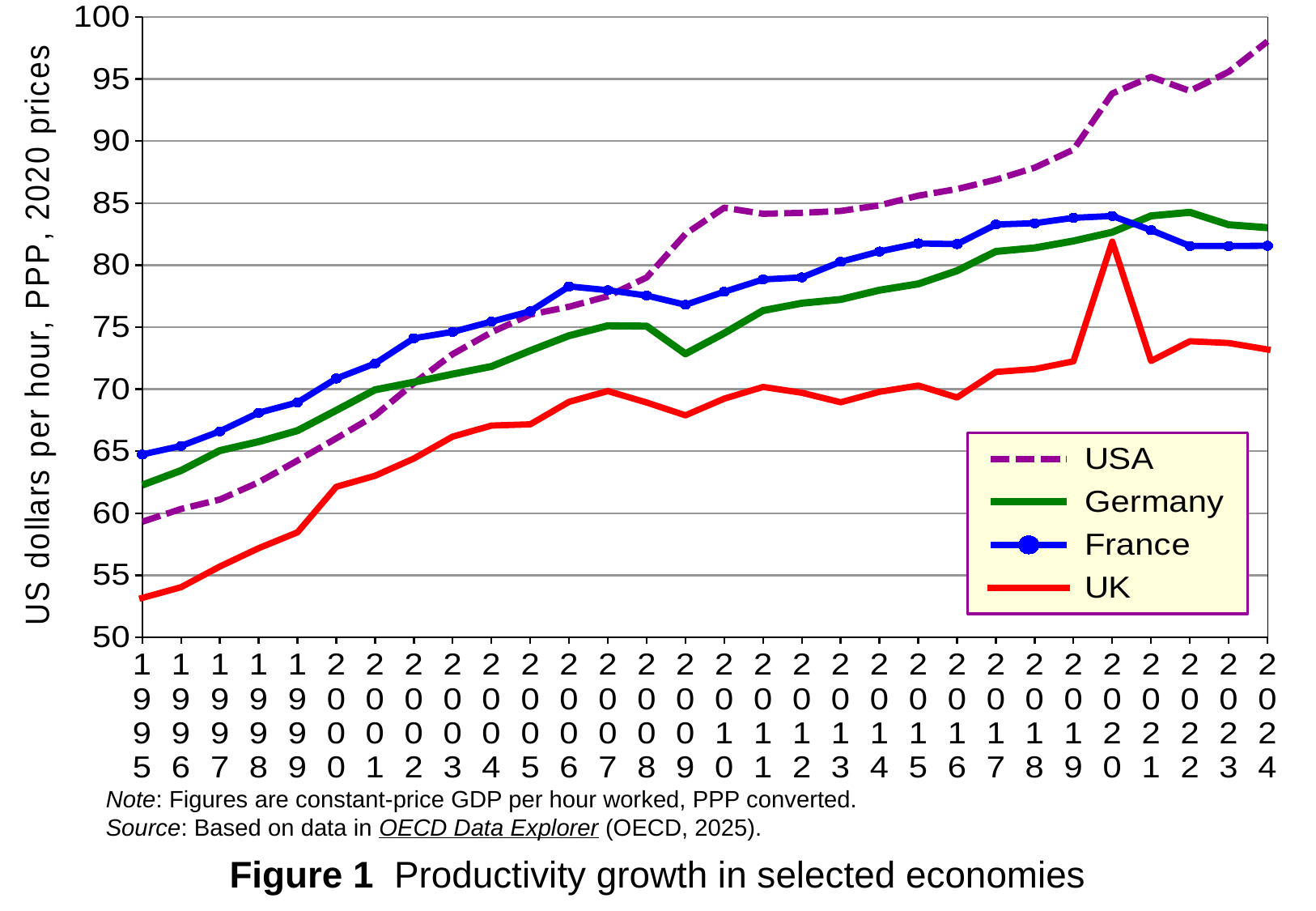
Which economy has the lowest value in 1995? UK Is the value for Germany in 2024 greater or less than 80? greater In 2009, which is larger, the value for France or the value for Germany? France How many years are plotted along the x axis? 30 How many series does the legend list? 4 Does the USA series rise or fall overall from 1995 to 2024? rise What kind of chart is shown in Figure 1? line chart Is the value for the USA in 2024 greater or less than 95? greater In 1995, which is larger, the value for the USA or the value for Germany? Germany Is the value for the UK in 1995 greater or less than 55? less Which economy has the lowest value in 2024? UK Which economy has the highest value in 2024? USA